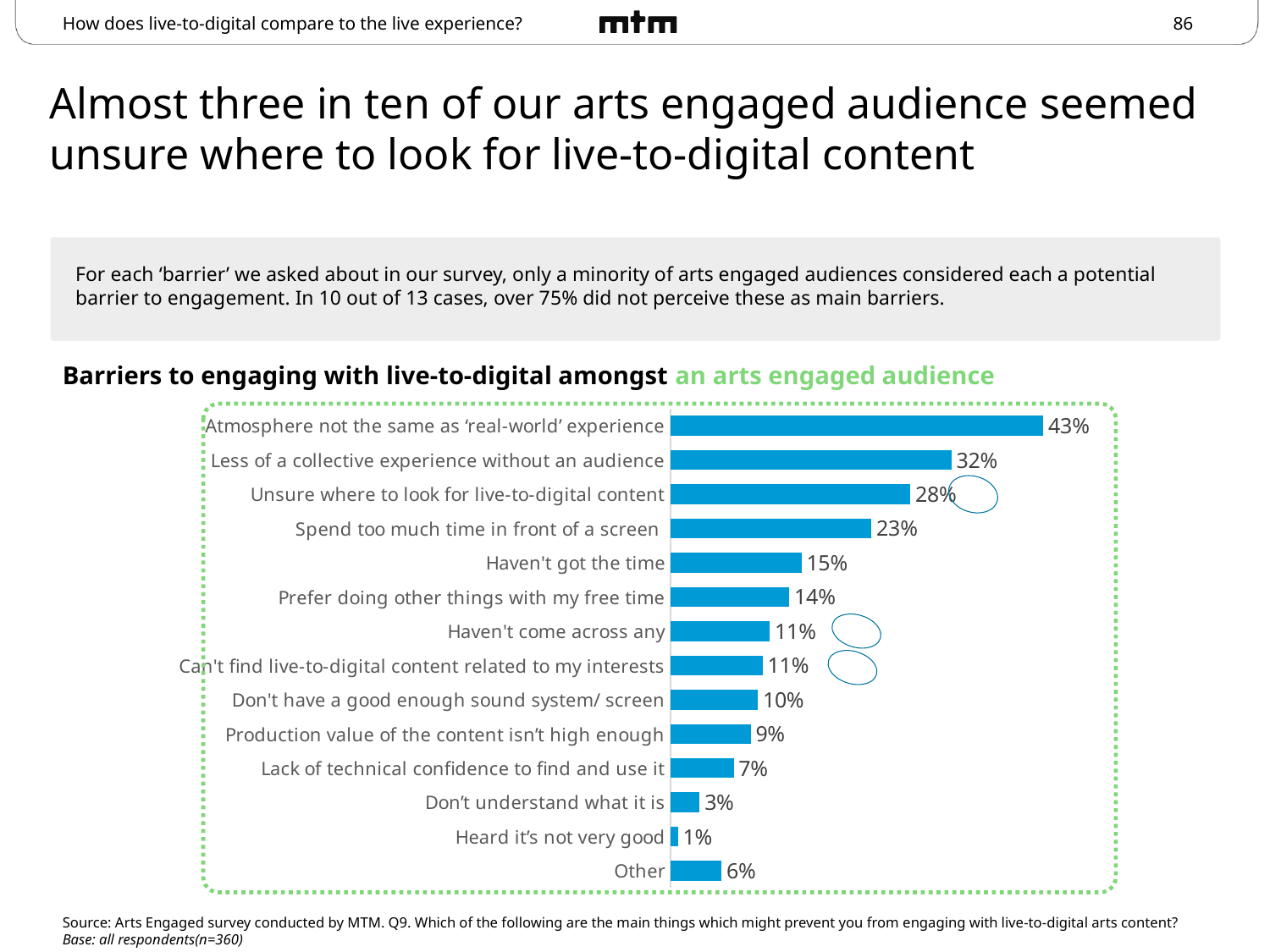
What type of chart is used to show the barriers? Bar chart Which barrier has the highest percentage? Atmosphere not the same as 'real-world' experience What is the difference between 'Atmosphere not the same as 'real-world' experience' and 'Less of a collective experience without an audience'? 11% What is the value for 'Spend too much time in front of a screen'? 23% How many barrier categories are shown in the chart? 14 What percentage of the arts engaged audience cited 'Unsure where to look for live-to-digital content' as a barrier? 28% Which barrier has the lowest percentage? Heard it's not very good What is the value for 'Lack of technical confidence to find and use it'? 7% What is the title of the chart? Barriers to engaging with live-to-digital amongst an arts engaged audience Which is larger: 'Haven't got the time' or 'Prefer doing other things with my free time'? Haven't got the time What is the difference between 'Other' and 'Don't understand what it is'? 3% What is the value for 'Don't have a good enough sound system/ screen'? 10%